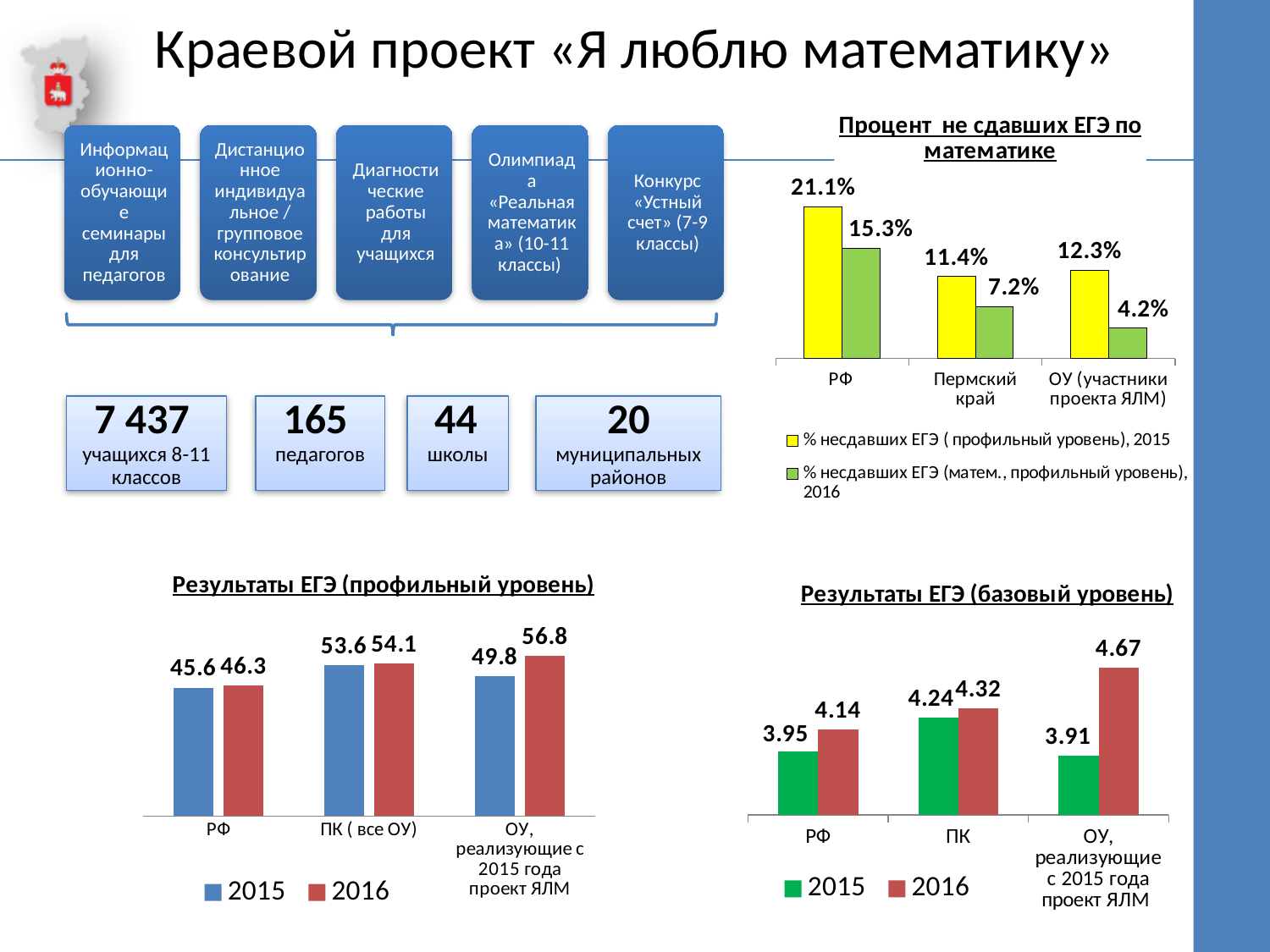
In the chart 'Процент не сдавших ЕГЭ по математике', what is the 2015 value for РФ? 21.1% In the chart 'Результаты ЕГЭ (профильный уровень)', which category has the highest 2015 value? ПК ( все ОУ) What kind of chart is 'Результаты ЕГЭ (профильный уровень)'? bar chart In the chart 'Процент не сдавших ЕГЭ по математике', what is the 2016 value for ОУ (участники проекта ЯЛМ)? 4.2% How many categories are shown in the chart 'Результаты ЕГЭ (базовый уровень)'? 3 In the chart 'Результаты ЕГЭ (базовый уровень)', what is the 2015 value for ПК? 4.24 In the chart 'Процент не сдавших ЕГЭ по математике', how many series does the legend list? 2 In the chart 'Результаты ЕГЭ (базовый уровень)', which is larger: the 2016 value for РФ or the 2016 value for ОУ, реализующие с 2015 года проект ЯЛМ? ОУ, реализующие с 2015 года проект ЯЛМ In the chart 'Процент не сдавших ЕГЭ по математике', which category has the lowest 2016 value? ОУ (участники проекта ЯЛМ) In the chart 'Результаты ЕГЭ (профильный уровень)', what is the difference between the 2016 and 2015 values for ОУ, реализующие с 2015 года проект ЯЛМ? 7.0 In the chart 'Результаты ЕГЭ (профильный уровень)', what is the 2016 value for ОУ, реализующие с 2015 года проект ЯЛМ? 56.8 In the chart 'Процент не сдавших ЕГЭ по математике', what is the difference between the 2015 and 2016 values for Пермский край? 4.2%